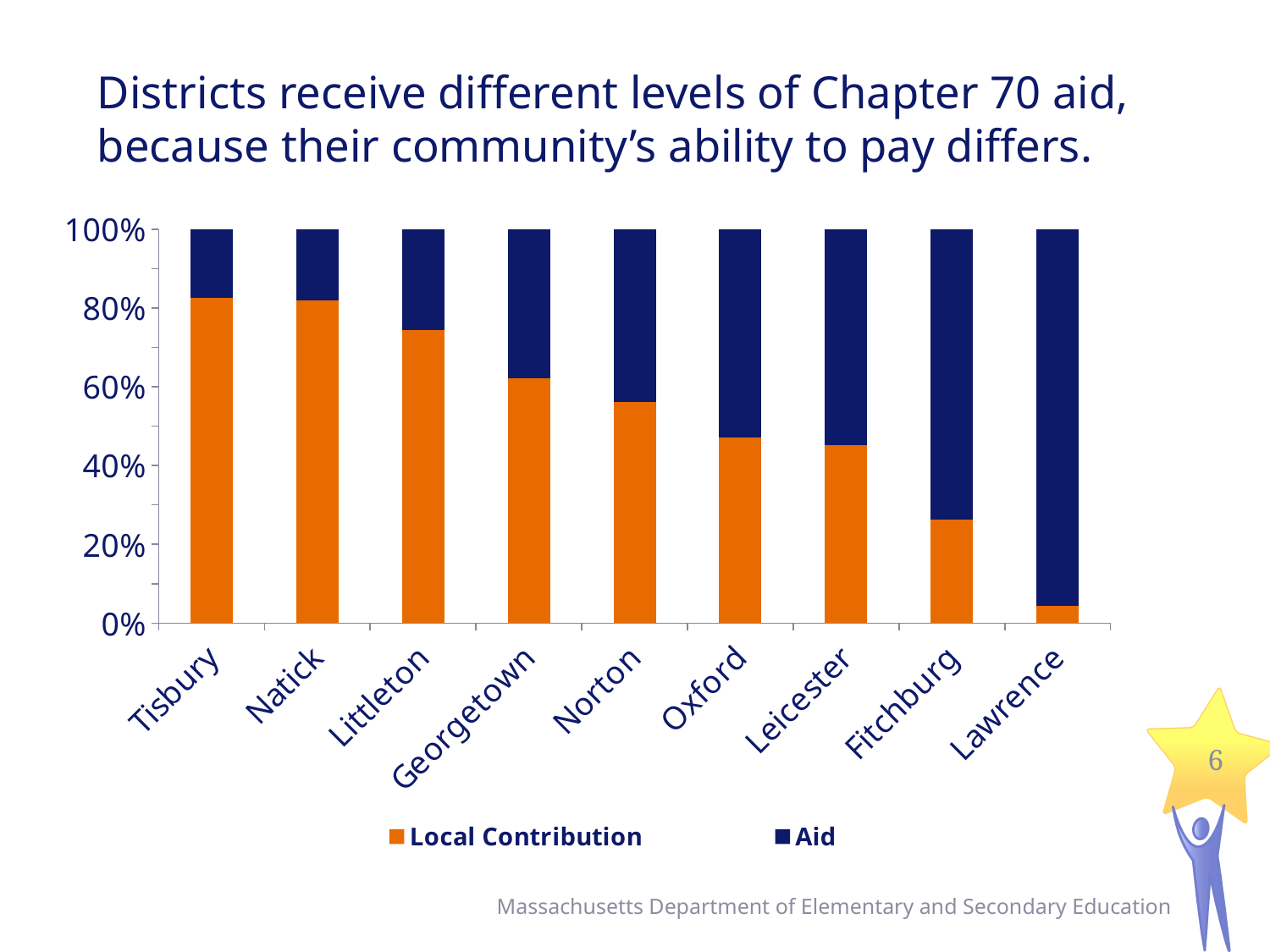
Which district has a larger Local Contribution share, Littleton or Georgetown? Littleton Which district has a larger Aid share, Oxford or Norton? Oxford Does the Local Contribution share rise or fall moving from Tisbury to Lawrence along the x axis? fall How many districts are shown on the x axis of the chart? 9 What kind of chart is shown on the slide? stacked bar chart Which colour represents Aid in the chart? dark blue How many series does the chart's legend list? 2 Is the Local Contribution share for Tisbury greater or less than 80%? greater Is the Local Contribution share for Georgetown greater or less than 60%? greater Which district has the highest Aid share? Lawrence Is the Local Contribution share for Fitchburg greater or less than 40%? less Which district has the lowest Local Contribution share? Lawrence